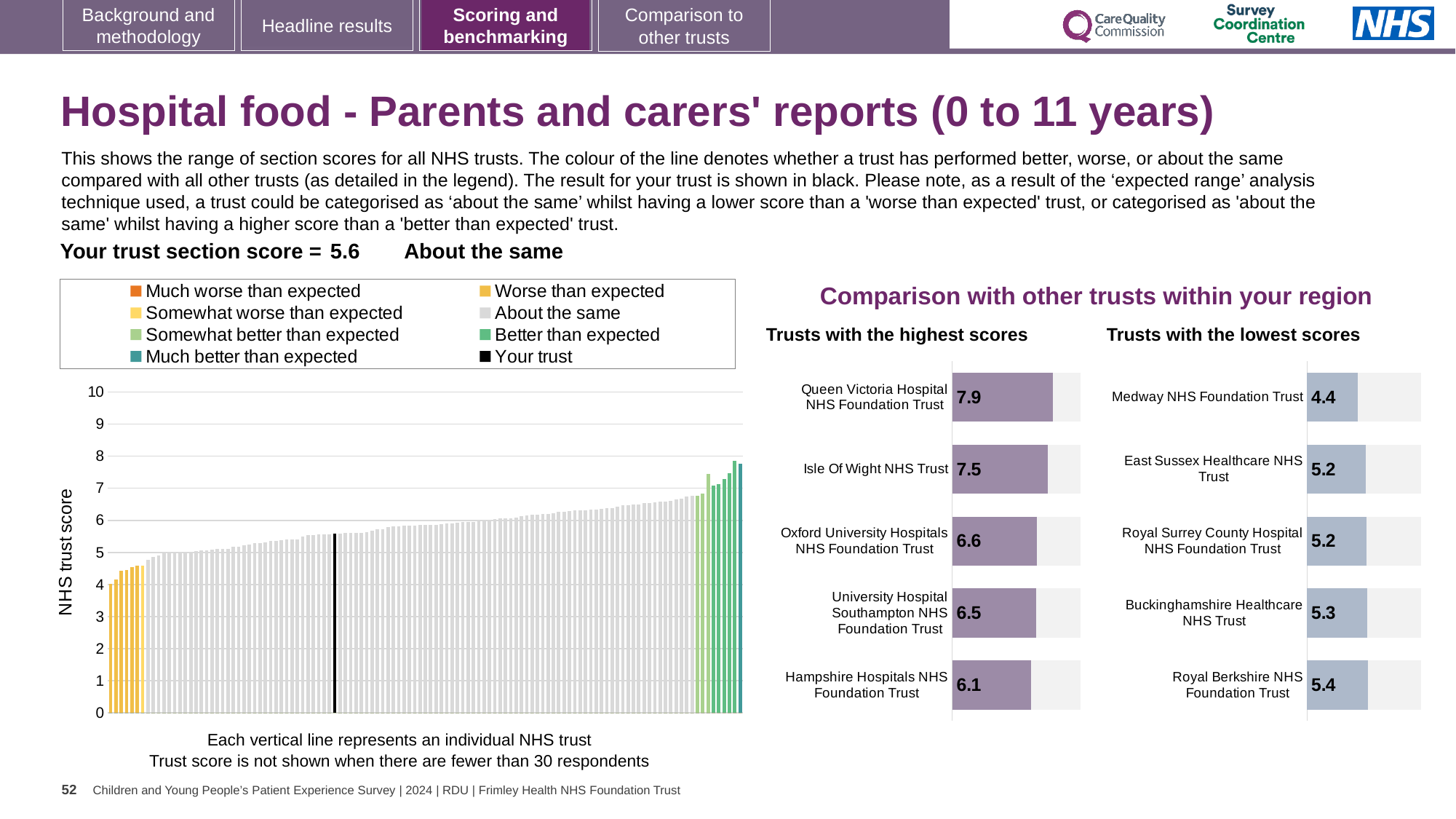
How many entries does the legend of the main 'NHS trust score' chart list? 8 In the 'Trusts with the lowest scores' chart, which trust has the highest score? Royal Berkshire NHS Foundation Trust In the 'Trusts with the highest scores' chart, what is the score for Hampshire Hospitals NHS Foundation Trust? 6.1 In the 'Trusts with the highest scores' chart, which trust has the lowest score? Hampshire Hospitals NHS Foundation Trust What kind of chart is the main 'NHS trust score' chart? bar chart In the 'Trusts with the highest scores' chart, what is the score for Queen Victoria Hospital NHS Foundation Trust? 7.9 In the main 'NHS trust score' chart, do the bar values rise or fall from left to right? rise In the 'Trusts with the highest scores' chart, what is the difference between the scores of Queen Victoria Hospital NHS Foundation Trust and Hampshire Hospitals NHS Foundation Trust? 1.8 In the 'Trusts with the lowest scores' chart, how many trusts are shown? 5 In the 'Trusts with the highest scores' chart, which has the higher score: Isle Of Wight NHS Trust or Oxford University Hospitals NHS Foundation Trust? Isle Of Wight NHS Trust In the main 'NHS trust score' chart, is the value for the black 'Your trust' bar greater or less than 5? greater In the 'Trusts with the lowest scores' chart, what is the score for Medway NHS Foundation Trust? 4.4